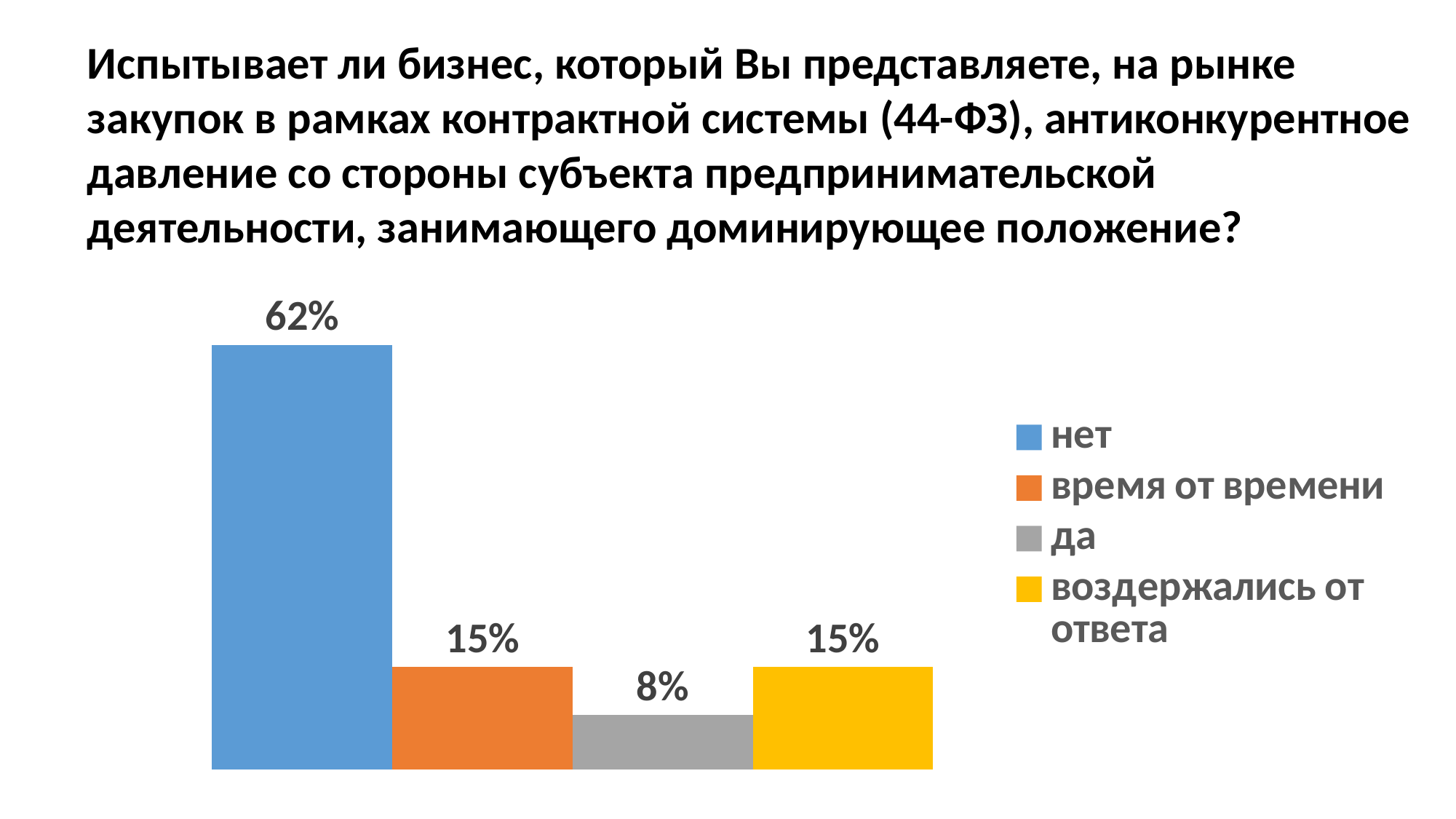
What percentage of respondents answered "нет"? 62% Which is larger: the share for "нет" or the share for "время от времени"? нет Which answer option has the highest share? нет What percentage of respondents answered "время от времени"? 15% How many answer options are shown in the chart? 4 What is the difference between the share for "время от времени" and the share for "да"? 7% What type of chart is shown on the slide? Bar chart Which answer option has the lowest share? да What is the difference between the share for "нет" and the share for "да"? 54% What percentage of respondents answered "да"? 8% What percentage of respondents chose "воздержались от ответа"? 15% What colour is the bar for "воздержались от ответа"? Yellow